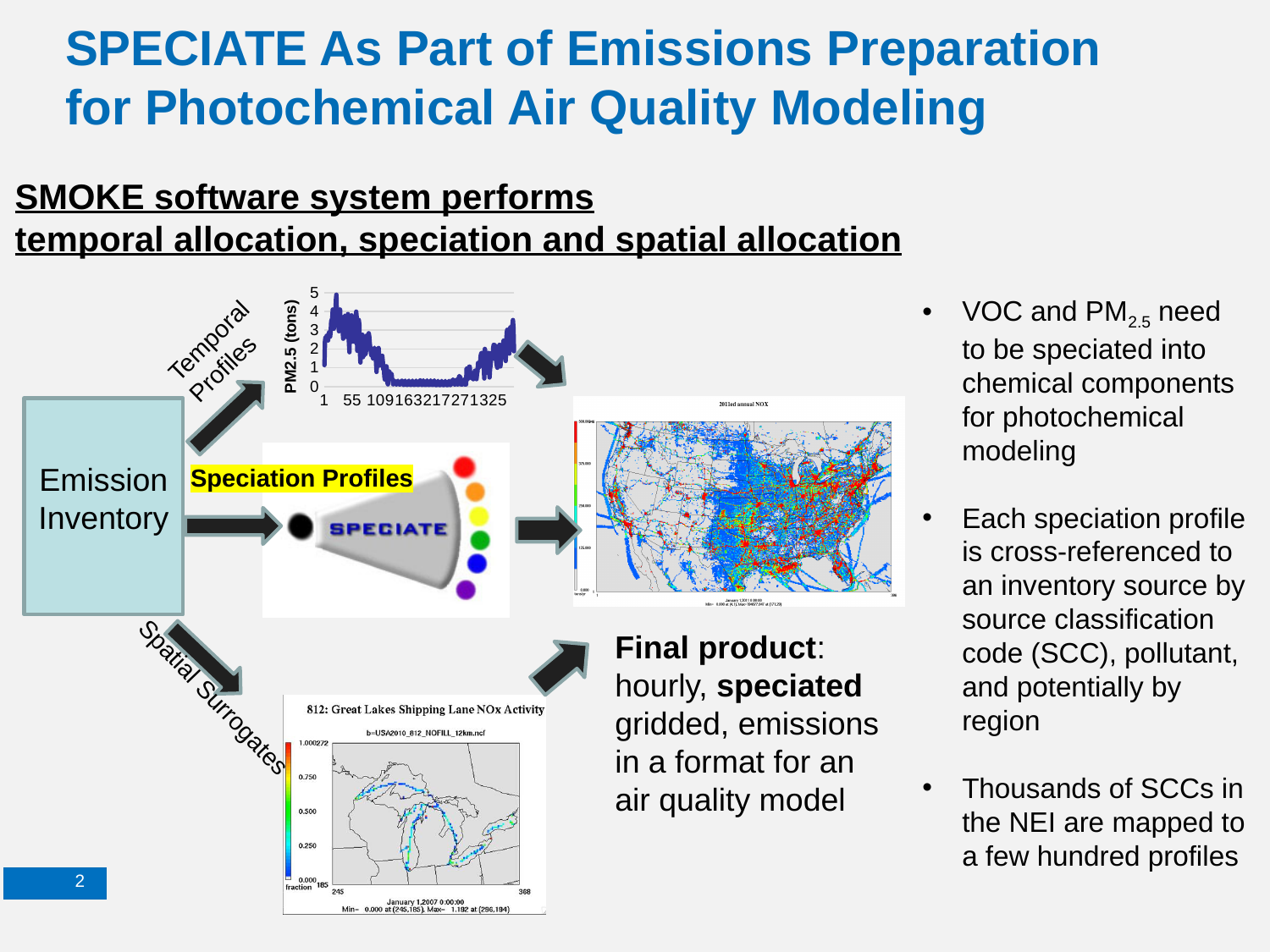
What kind of chart is the temporal profile chart at the top of the slide (the one with the PM2.5 (tons) axis)? line chart In the temporal profile line chart, is the value near x = 1 greater or less than 2? less In the temporal profile line chart, is the value near x = 217 greater or less than 3? less In the temporal profile line chart, is the value near x = 55 larger or smaller than the value near x = 163? larger In the temporal profile line chart, is the value around x = 163 greater or less than 1? less In the temporal profile line chart, what is the last tick label on the horizontal axis? 325 In the temporal profile line chart, what is the highest tick value shown on the vertical axis? 5 In the temporal profile line chart, how many tick labels are shown along the horizontal axis? 7 In the temporal profile line chart, what is the label on the vertical axis? PM2.5 (tons) In the temporal profile line chart, do the values rise or fall between x = 1 and x = 163? fall In the temporal profile line chart, do the values rise or fall between x = 217 and x = 325? rise